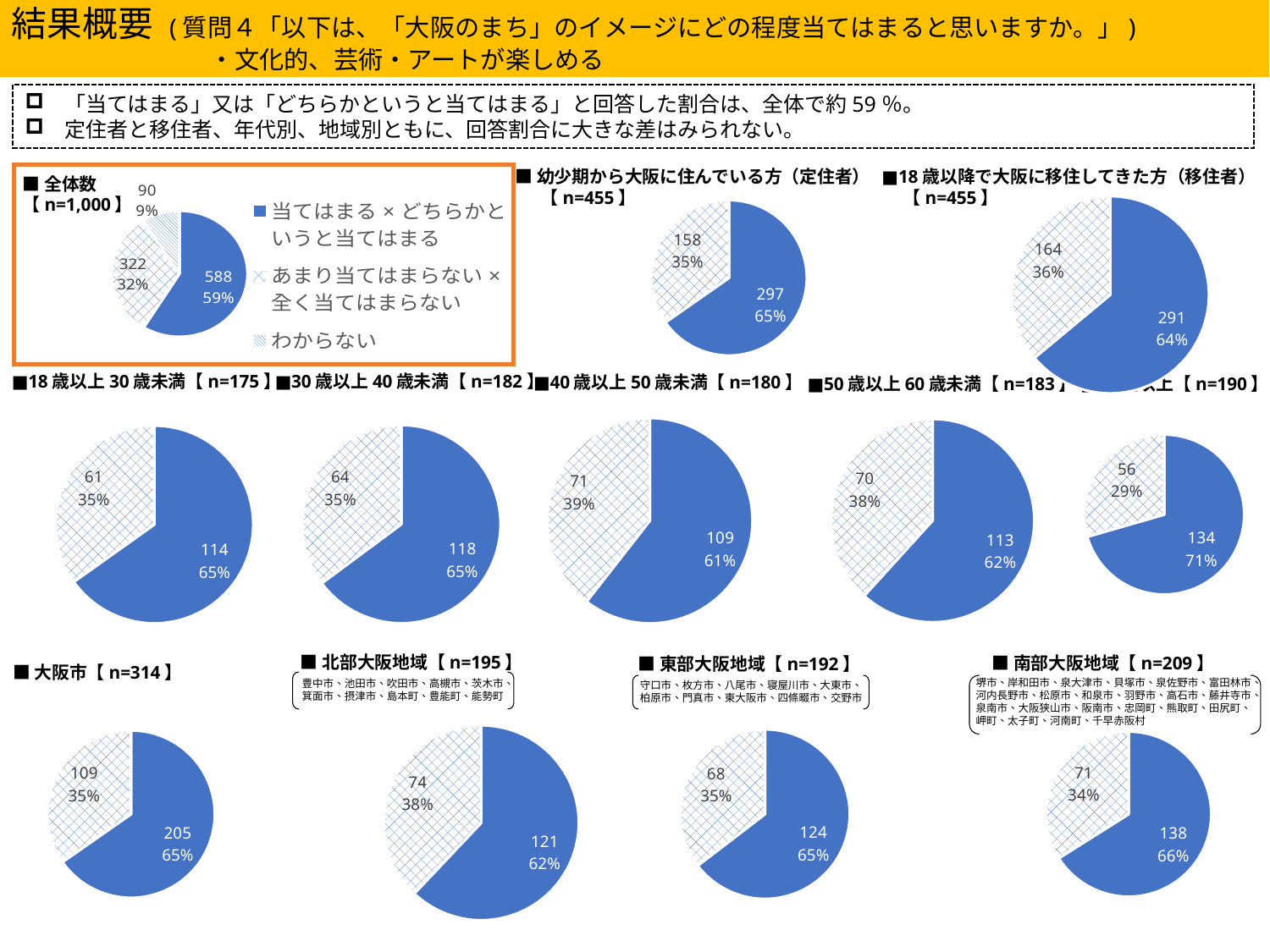
「幼少期から大阪に住んでいる方（定住者）【n=455】」の円グラフで、「当てはまる × どちらかというと当てはまる」の回答数はいくつですか。 297 地域別の4つの円グラフのうち、「当てはまる × どちらかというと当てはまる」の割合が最も低いのはどの地域ですか。 北部大阪地域【n=195】 「18歳以降で大阪に移住してきた方（移住者）【n=455】」の円グラフで、「あまり当てはまらない × 全く当てはまらない」の割合は何%ですか。 36% 「大阪市【n=314】」の円グラフで、「当てはまる × どちらかというと当てはまる」の回答数はいくつですか。 205 「40歳以上50歳未満【n=180】」の円グラフで、「あまり当てはまらない × 全く当てはまらない」の割合は何%ですか。 39% 「全体数【n=1,000】」の円グラフで、「当てはまる × どちらかというと当てはまる」の割合は何%ですか。 59% このスライドに使われているグラフの種類は何ですか。 円グラフ 「全体数【n=1,000】」の円グラフの凡例には、いくつの項目がありますか。 3 年代別の5つの円グラフのうち、「当てはまる × どちらかというと当てはまる」の割合が最も高いのはどの年代ですか。 60歳以上【n=190】 「南部大阪地域【n=209】」の円グラフで、「当てはまる × どちらかというと当てはまる」の割合は何%ですか。 66% 「幼少期から大阪に住んでいる方（定住者）」と「18歳以降で大阪に移住してきた方（移住者）」の円グラフで、「当てはまる × どちらかというと当てはまる」の回答数の差はいくつですか。 6 「全体数【n=1,000】」の円グラフで、「わからない」の回答数はいくつですか。 90